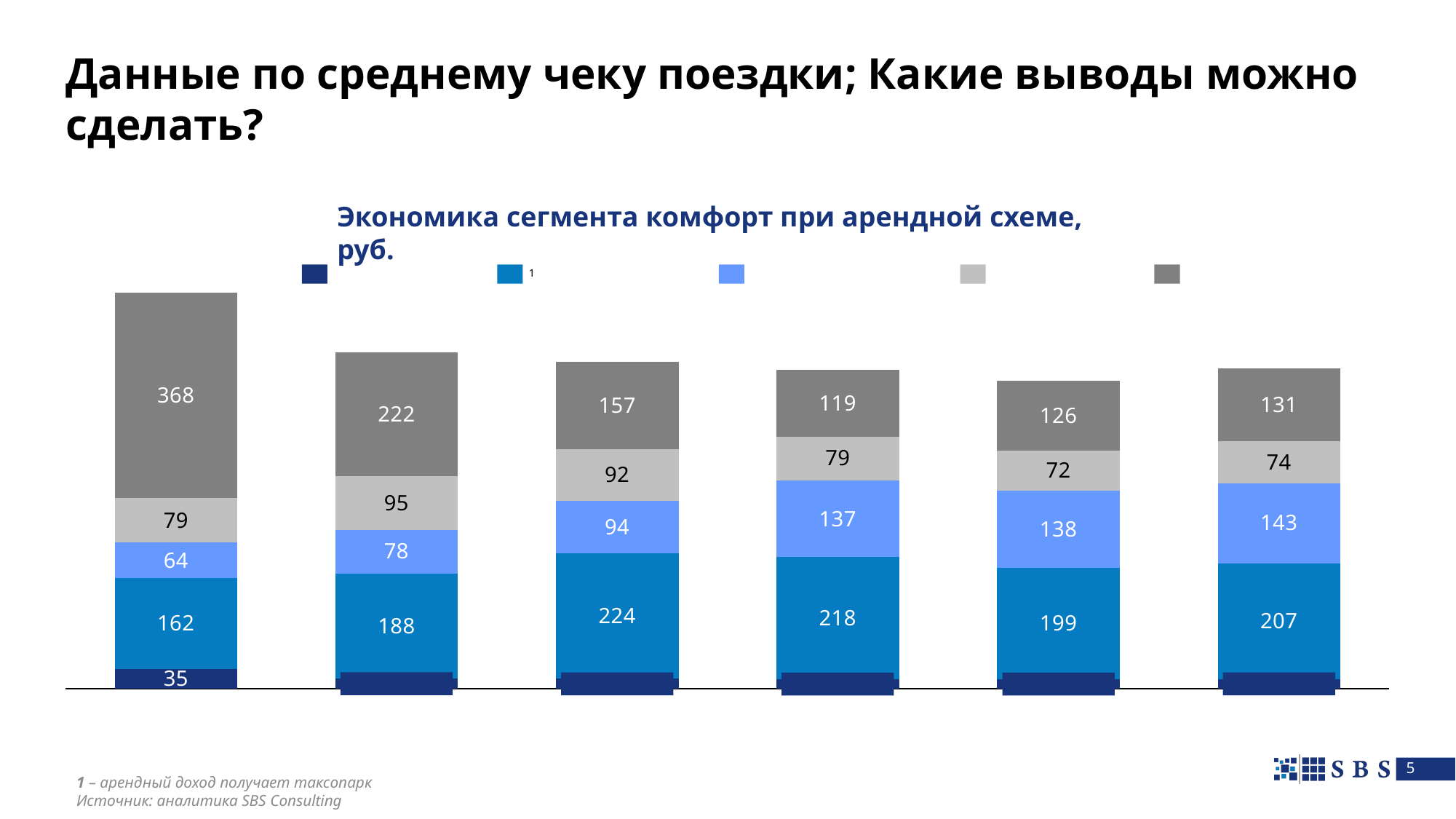
Which bar has the largest dark grey (top) segment? The leftmost bar (368) Which is larger: the medium blue segment of the second bar or the medium blue segment of the fifth bar? The fifth bar (199) How many series (colour squares) does the legend show? 5 How many bars are plotted in the chart? 6 What kind of chart is shown on the slide? Stacked bar chart What is the value of the dark grey (top) segment of the leftmost bar? 368 What is the difference between the light blue segment of the rightmost bar and the light blue segment of the leftmost bar? 79 What is the total of the leftmost stacked bar? 708 What is the value of the medium blue segment of the third bar from the left? 224 What is the value of the light grey segment of the fourth bar from the left? 79 Which bar has the smallest light blue segment? The leftmost bar (64) Do the light blue segment values rise or fall from the leftmost bar to the rightmost bar? Rise